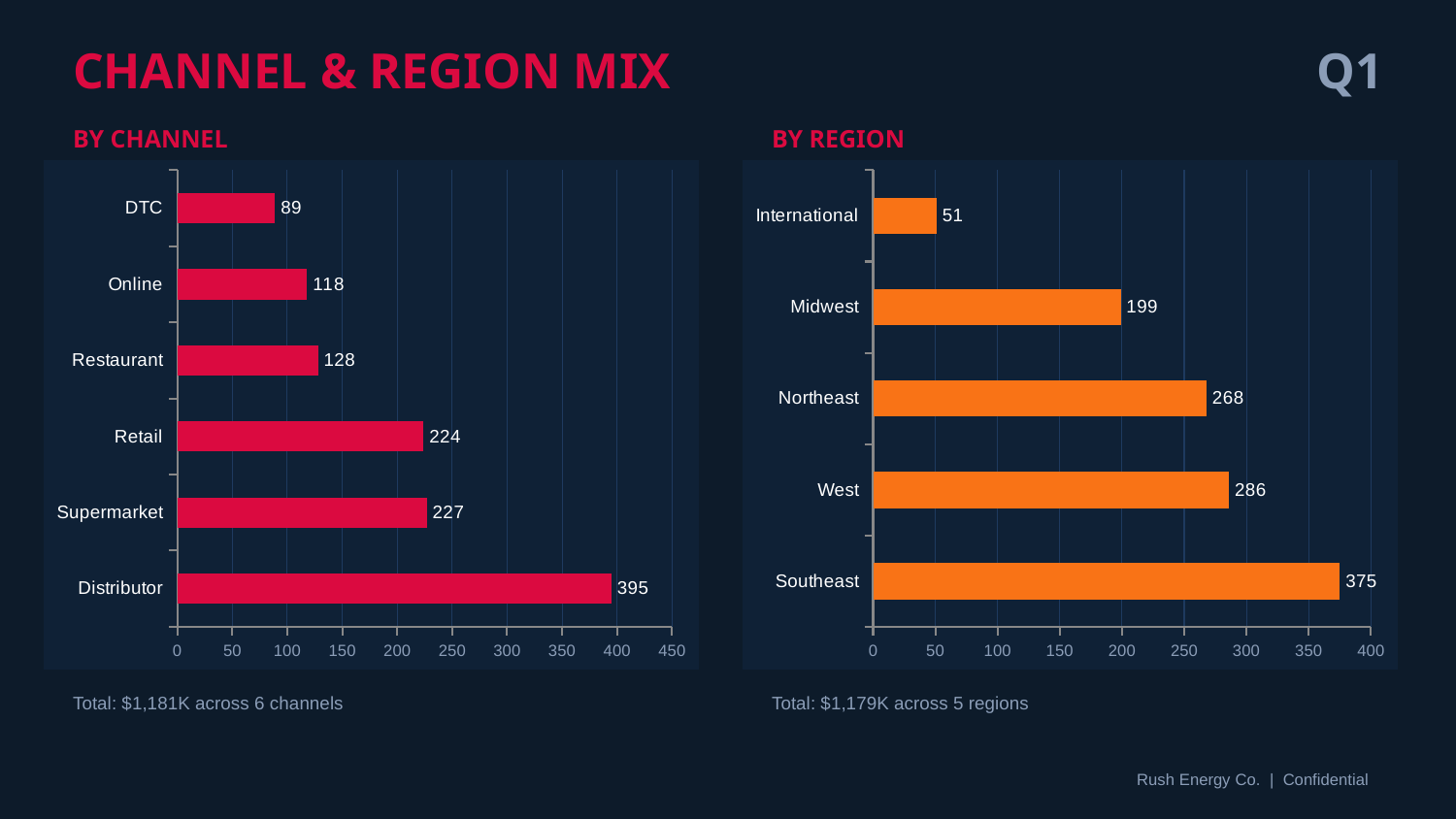
In the BY REGION chart, what is the value for Northeast? 268 In the BY CHANNEL chart, what is the value for Retail? 224 In the BY REGION chart, what is the difference between Southeast and Midwest? 176 What kind of chart is the BY REGION chart? Bar chart How many regions are shown in the BY REGION chart? 5 In the BY REGION chart, which region has the lowest value? International How many channels are shown in the BY CHANNEL chart? 6 In the BY CHANNEL chart, what is the difference between Distributor and DTC? 306 What colour are the bars in the BY CHANNEL chart? Red In the BY CHANNEL chart, is the value for Online greater or less than 100? greater In the BY REGION chart, which is larger, West or Northeast? West In the BY CHANNEL chart, which channel has the highest value? Distributor